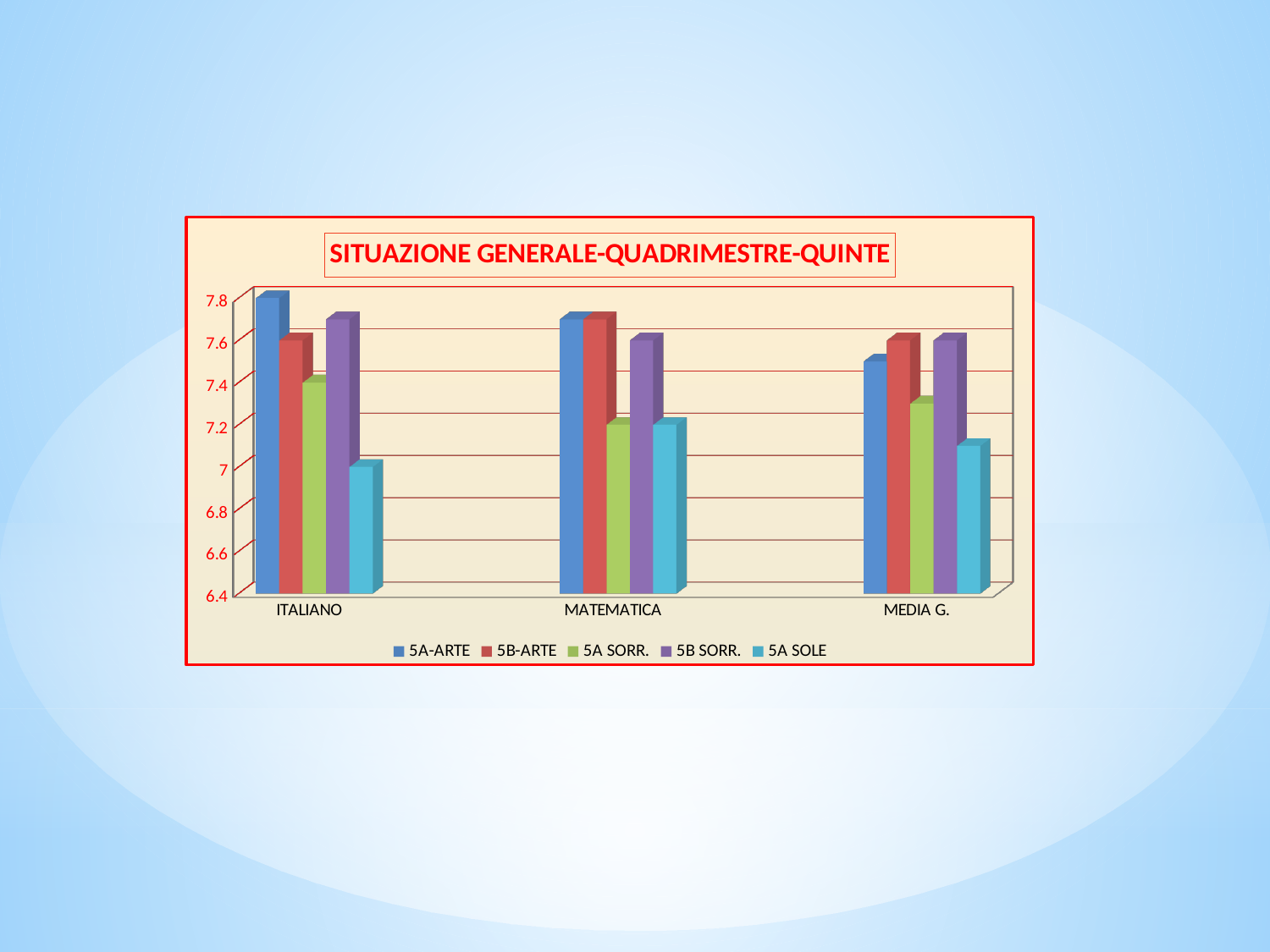
For MATEMATICA, which is larger: 5B SORR. or 5A SORR.? 5B SORR. What kind of chart is shown on the slide? bar chart Which series has the lowest value for ITALIANO? 5A SOLE Is the value for 5B SORR. in MATEMATICA greater or less than 7.4? greater For ITALIANO, which is larger: 5A SORR. or 5A SOLE? 5A SORR. Does the value for 5A-ARTE rise or fall from ITALIANO to MEDIA G.? fall Which series has the lowest value for MEDIA G.? 5A SOLE How many categories are shown on the x axis? 3 How many series does the legend list? 5 Which series has the highest value for ITALIANO? 5A-ARTE What is the title of the chart? SITUAZIONE GENERALE-QUADRIMESTRE-QUINTE Is the value for 5A SOLE in ITALIANO greater or less than 7.2? less